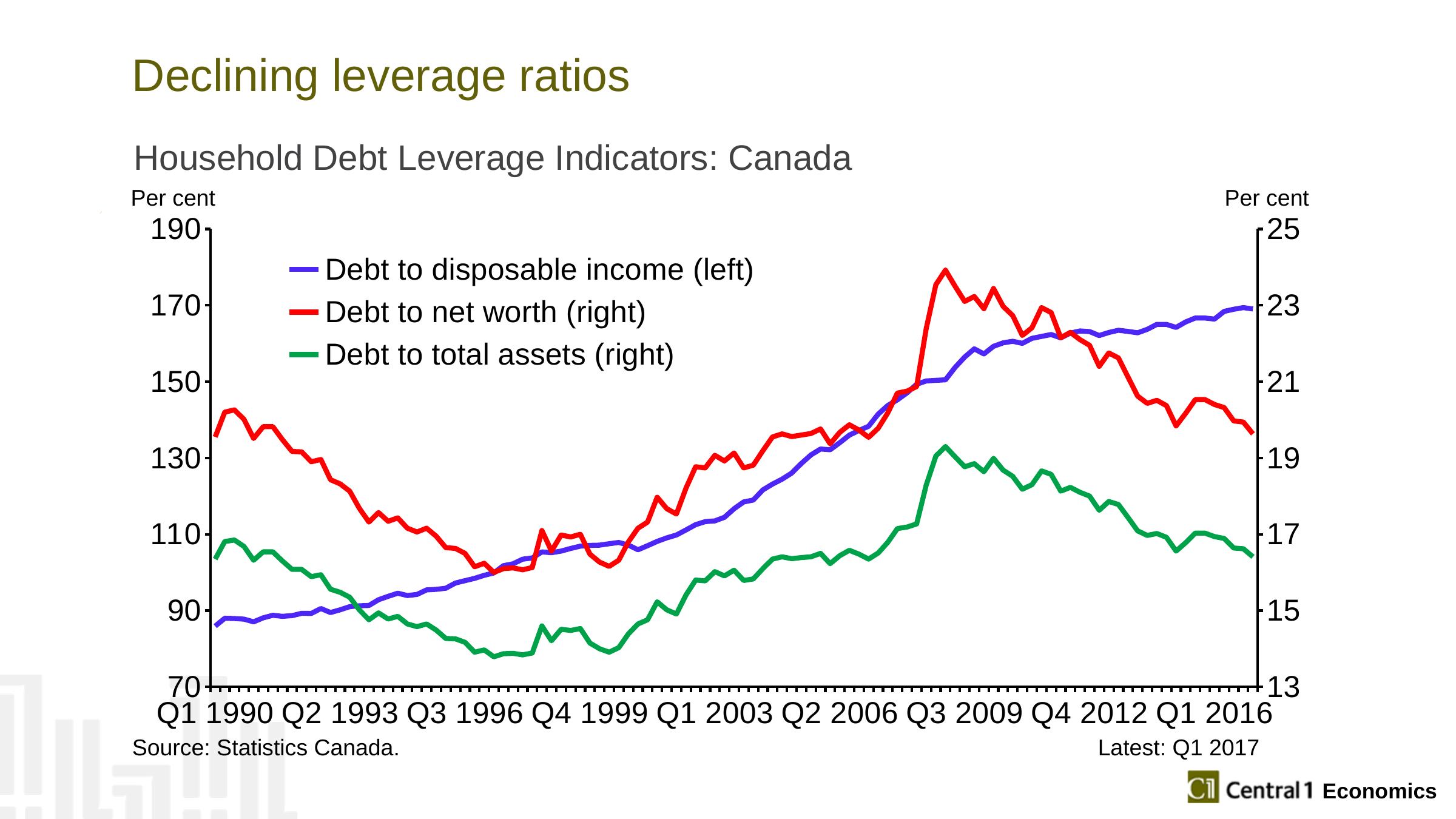
Is the peak value of Debt to net worth around 2009 greater or less than 23? greater Which series is plotted against the left axis? Debt to disposable income Does Debt to net worth rise or fall from its 2009 peak to 2016? fall At the end of the series in 2016, which is higher on the right axis: Debt to net worth or Debt to total assets? Debt to net worth How many series does the legend list? 3 Is the value for Debt to disposable income at Q1 2016 greater or less than 150? greater What is the source cited for the chart? Statistics Canada Does Debt to disposable income rise or fall overall from Q1 1990 to Q1 2016? rise What kind of chart is shown on the slide? line chart Is the value for Debt to total assets at Q1 1990 greater or less than 19? less Of the two series plotted on the right axis, which one is lower throughout the whole period? Debt to total assets